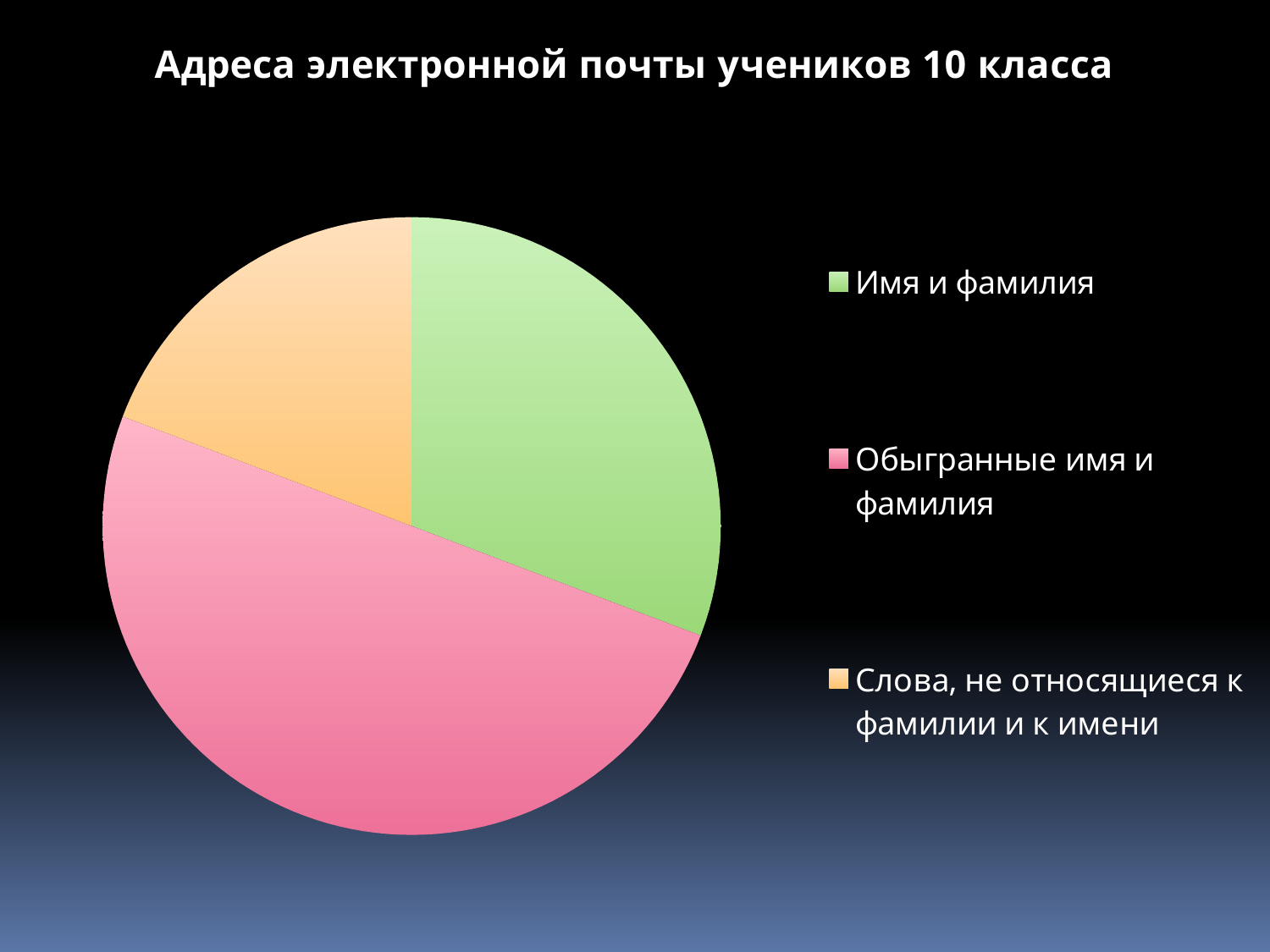
What is the title of the chart? Адреса электронной почты учеников 10 класса What kind of chart is shown on the slide? Pie chart How many entries does the legend list? 3 Which category has the smallest slice of the pie? Слова, не относящиеся к фамилии и к имени Which slice is larger: "Имя и фамилия" or "Слова, не относящиеся к фамилии и к имени"? Имя и фамилия Which category has the largest slice of the pie? Обыгранные имя и фамилия What colour is the slice for "Обыгранные имя и фамилия"? Pink How many slices does the pie chart have? 3 Which slice is larger: "Обыгранные имя и фамилия" or "Имя и фамилия"? Обыгранные имя и фамилия